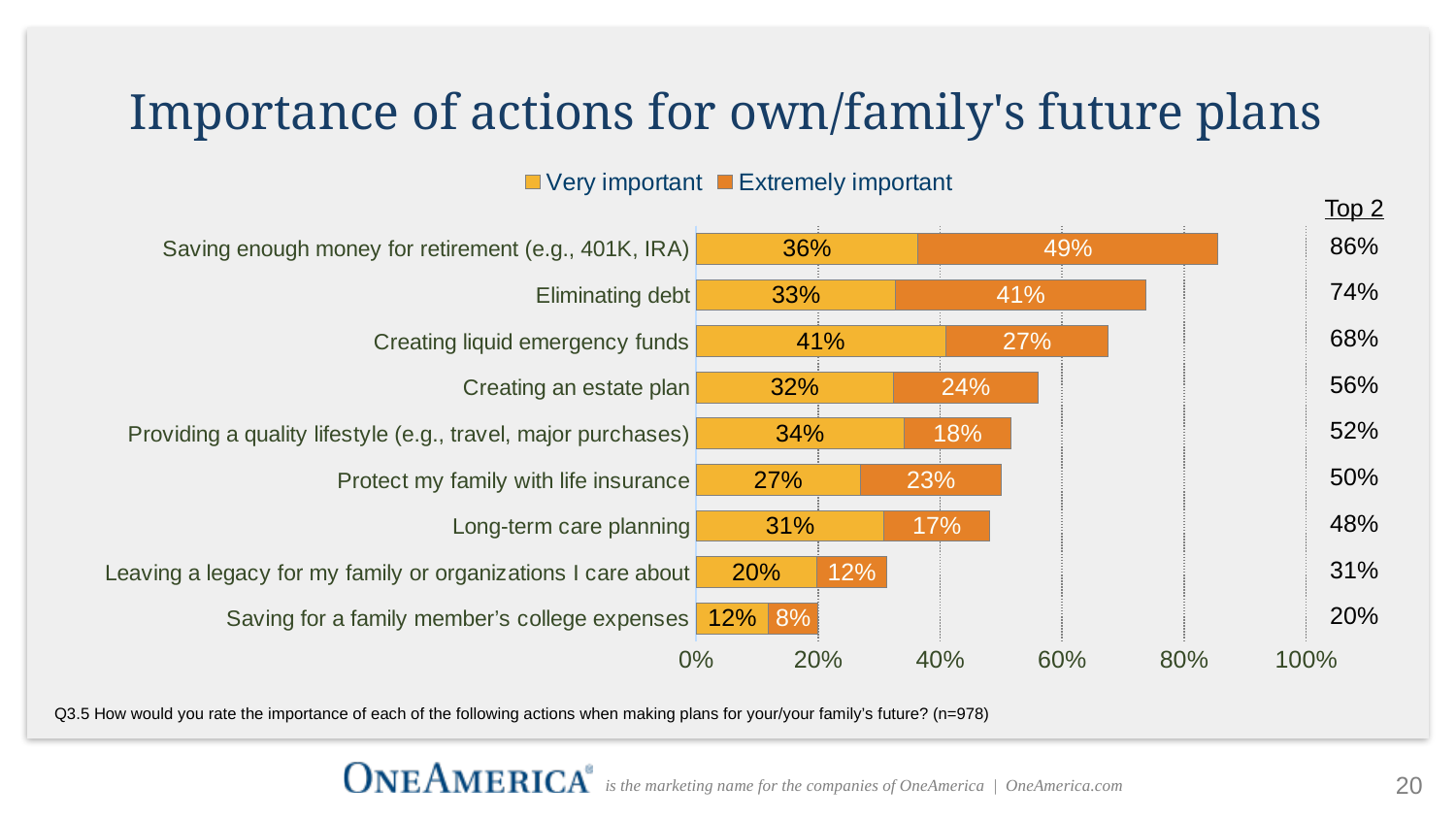
What is the difference between the Extremely important percentages for 'Saving enough money for retirement (e.g., 401K, IRA)' and 'Eliminating debt'? 8% Which action has the lowest Top 2 value? Saving for a family member's college expenses How many series does the legend list? 2 What percentage rated 'Creating liquid emergency funds' as Very important? 41% What is the Top 2 value for 'Long-term care planning'? 48% How many actions are listed in the chart? 9 Which action has the highest Extremely important percentage? Saving enough money for retirement (e.g., 401K, IRA) Which colour represents 'Extremely important' in the chart? Orange What kind of chart is shown on the slide? Stacked bar chart Which is larger: the Very important percentage for 'Creating an estate plan' or for 'Providing a quality lifestyle (e.g., travel, major purchases)'? Providing a quality lifestyle (e.g., travel, major purchases) What is the total of the stacked bar for 'Protect my family with life insurance'? 50% What percentage rated 'Eliminating debt' as Extremely important? 41%